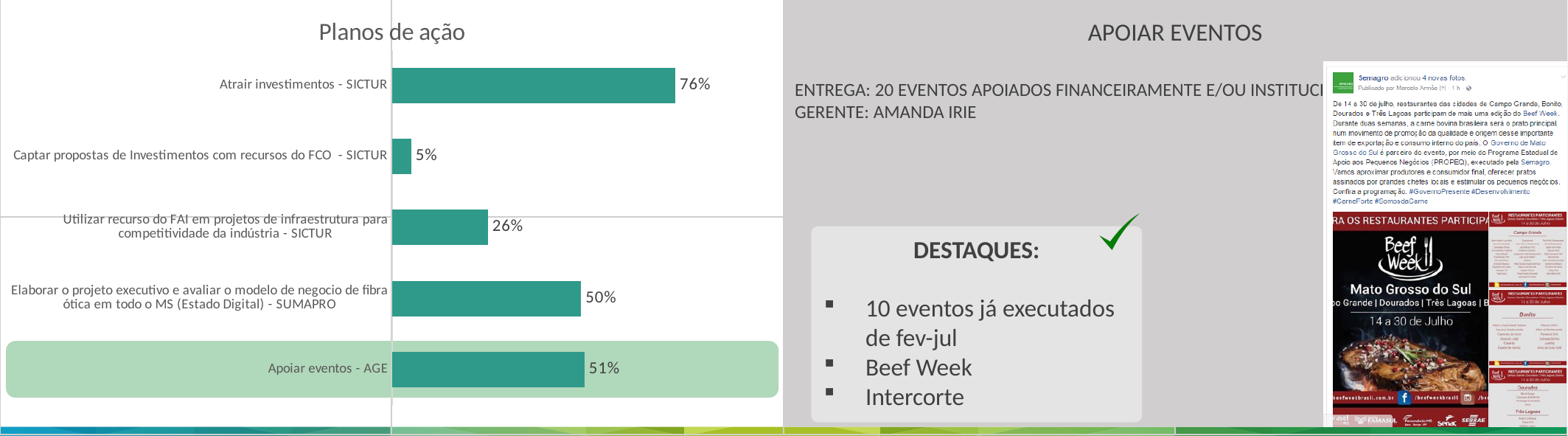
In the Planos de ação chart, what is the difference between the value for "Elaborar o projeto executivo e avaliar o modelo de negocio de fibra ótica em todo o MS (Estado Digital) - SUMAPRO" and the value for "Utilizar recurso do FAI em projetos de infraestrutura para competitividade da indústria - SICTUR"? 24% What is the value for "Apoiar eventos - AGE" in the Planos de ação chart? 51% Which category has the highest value in the Planos de ação chart? Atrair investimentos - SICTUR What is the title of the chart on the left side of the slide? Planos de ação Which category has the lowest value in the Planos de ação chart? Captar propostas de Investimentos com recursos do FCO - SICTUR In the Planos de ação chart, which is larger: the value for "Atrair investimentos - SICTUR" or the value for "Elaborar o projeto executivo e avaliar o modelo de negocio de fibra ótica em todo o MS (Estado Digital) - SUMAPRO"? Atrair investimentos - SICTUR In the Planos de ação chart, what is the difference between the value for "Atrair investimentos - SICTUR" and the value for "Apoiar eventos - AGE"? 25% How many categories are shown in the Planos de ação chart? 5 What is the value for "Captar propostas de Investimentos com recursos do FCO - SICTUR" in the Planos de ação chart? 5% What is the value for "Utilizar recurso do FAI em projetos de infraestrutura para competitividade da indústria - SICTUR" in the Planos de ação chart? 26% What kind of chart is the Planos de ação chart? Bar chart What is the value for "Atrair investimentos - SICTUR" in the Planos de ação chart? 76%